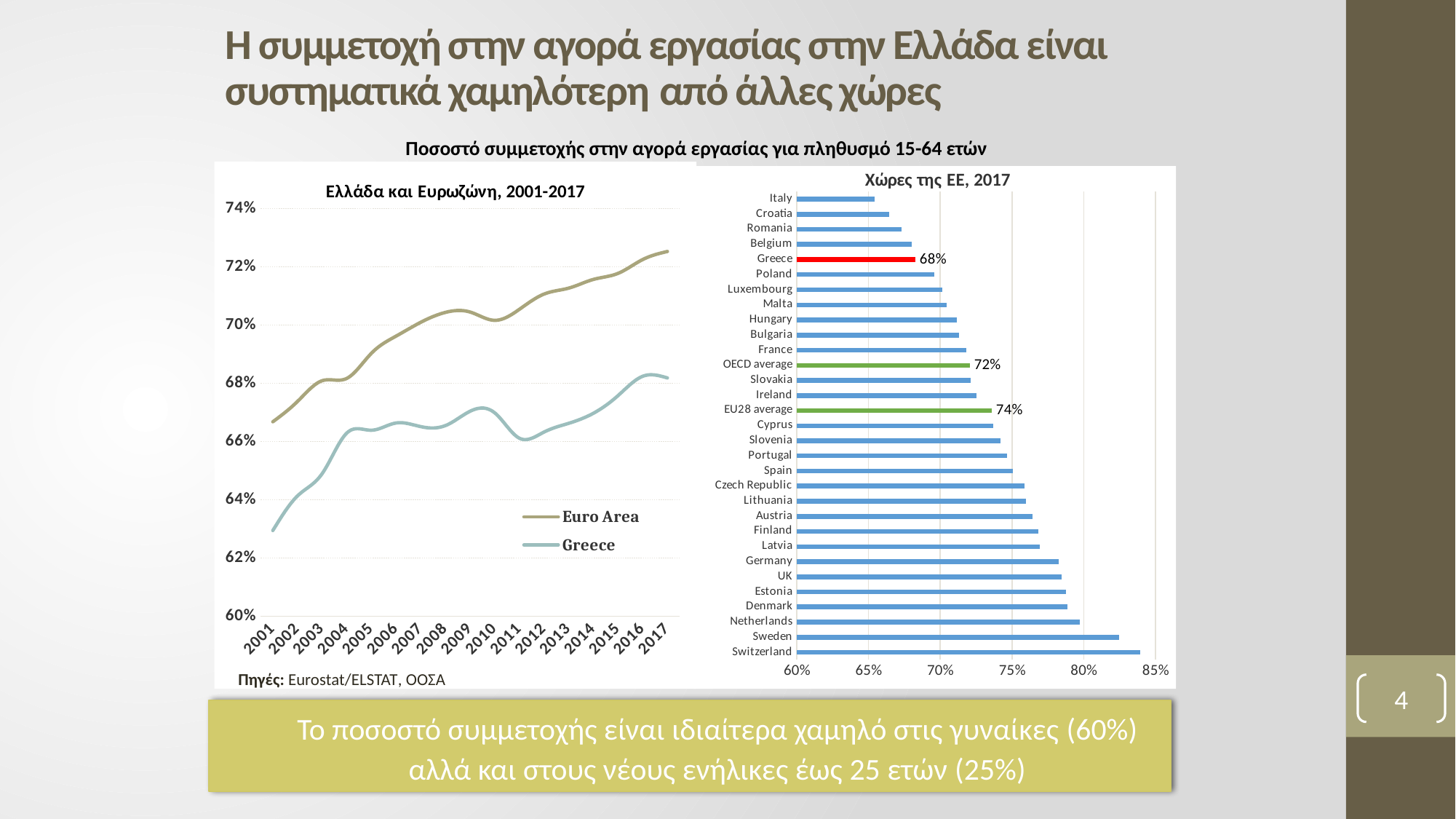
In the right chart 'Χώρες της ΕΕ, 2017', what is the difference between the EU28 average and Greece? 6 percentage points In the right chart 'Χώρες της ΕΕ, 2017', what is the value for the EU28 average? 74% In the right chart 'Χώρες της ΕΕ, 2017', which country has the lowest participation rate? Italy In the right chart 'Χώρες της ΕΕ, 2017', what is the value for Greece? 68% In the right chart 'Χώρες της ΕΕ, 2017', is the value for Italy greater or less than 70%? less In the right chart 'Χώρες της ΕΕ, 2017', which country has the highest participation rate? Switzerland In the right chart 'Χώρες της ΕΕ, 2017', how many bars are plotted? 31 In the left chart 'Ελλάδα και Ευρωζώνη, 2001-2017', is the value for Greece in 2001 greater or less than 64%? less In the left chart 'Ελλάδα και Ευρωζώνη, 2001-2017', does the Euro Area line rise or fall overall from 2001 to 2017? rise In the right chart 'Χώρες της ΕΕ, 2017', is the value for Switzerland greater or less than 80%? greater In the right chart 'Χώρες της ΕΕ, 2017', what is the value for the OECD average? 72% In the left chart 'Ελλάδα και Ευρωζώνη, 2001-2017', how many series does the legend list? 2